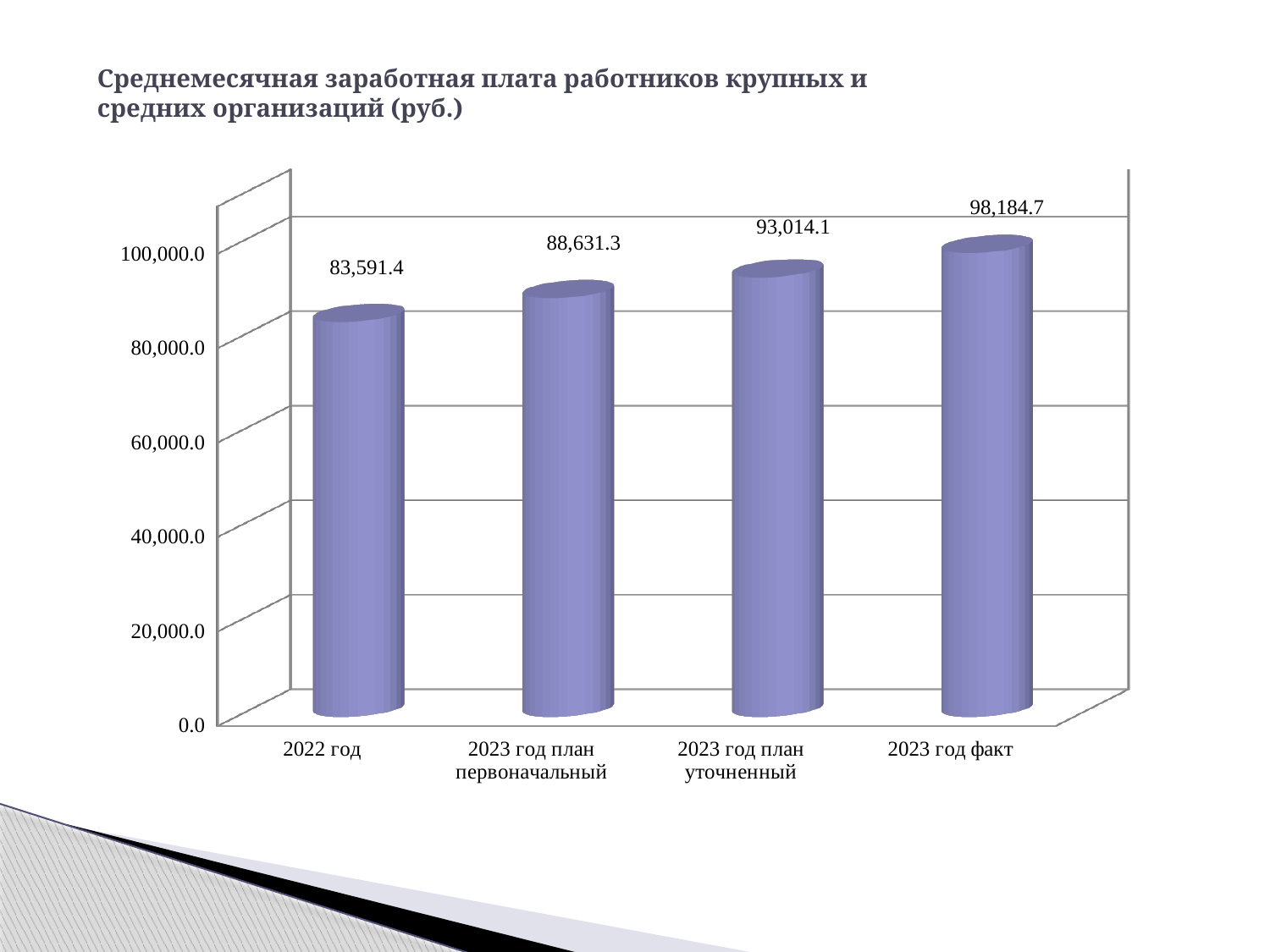
What is the value for 2022 год? 83,591.4 What is the value for 2023 год факт? 98,184.7 Which is larger, the value for 2023 год план уточненный or the value for 2023 год факт? 2023 год факт What is the value for 2023 год план первоначальный? 88,631.3 What is the difference between the values for 2023 год план уточненный and 2023 год план первоначальный? 4,382.8 What is the value for 2023 год план уточненный? 93,014.1 Is the value for 2022 год greater or less than 100,000.0? less Do the values rise or fall from left to right along the x axis? rise How many categories are shown on the x axis? 4 What is the difference between the values for 2023 год факт and 2022 год? 14,593.3 Which category has the highest value? 2023 год факт Which category has the lowest value? 2022 год